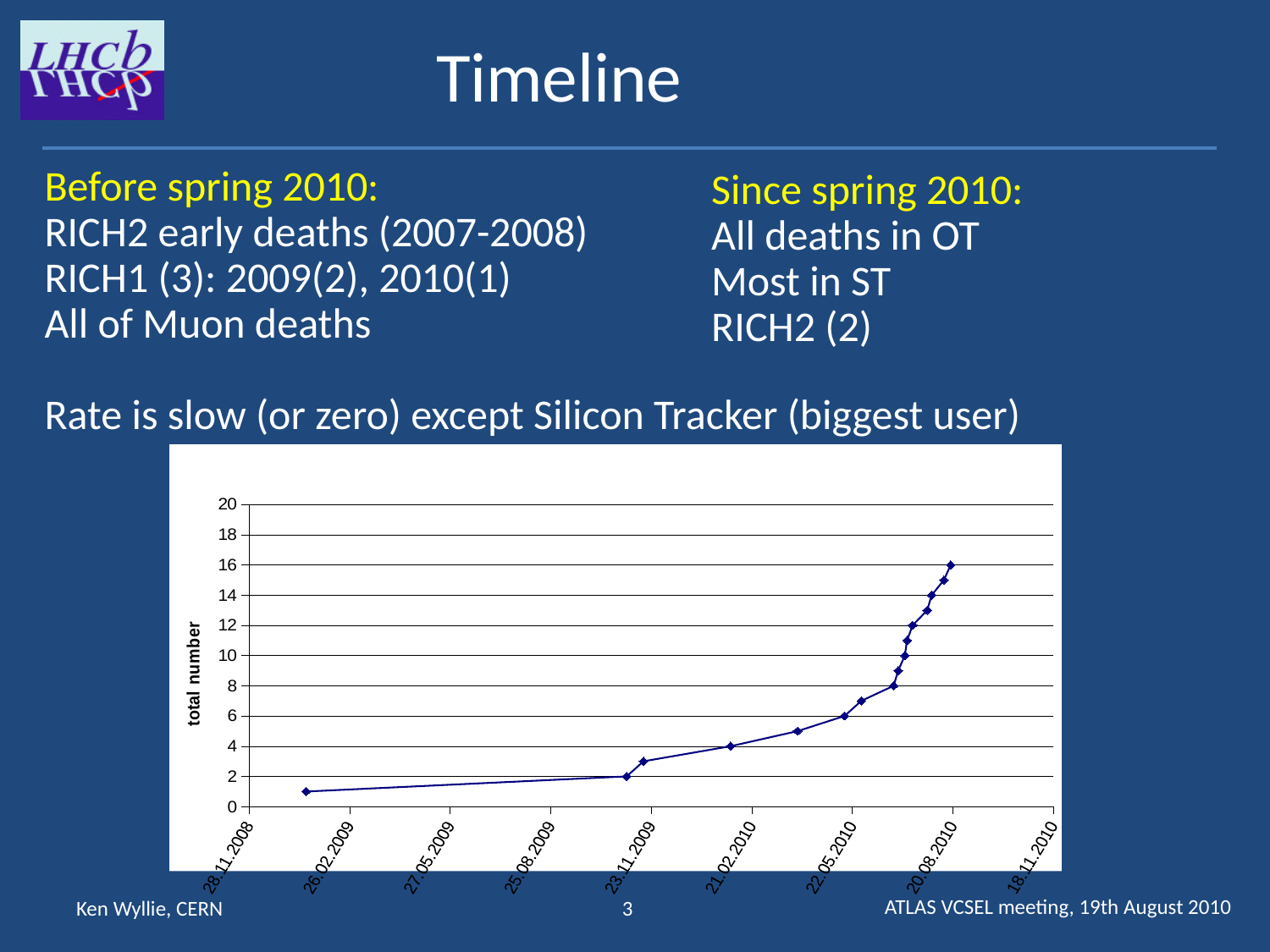
What is the label of the y axis in the chart? total number Is the final (rightmost) value of the line greater or less than 14? greater Which is larger: the value of the line near 20.08.2010 or the value near 26.02.2009? 20.08.2010 What is the highest value reached by the line in the chart? 16 Is the first (leftmost) value of the line greater or less than 2? less Do the values in the chart rise or fall over time along the x axis? rise Is the value of the line at 22.05.2010 greater or less than 10? less What kind of chart is shown on the slide? line chart What is the maximum value shown on the y axis of the chart? 20